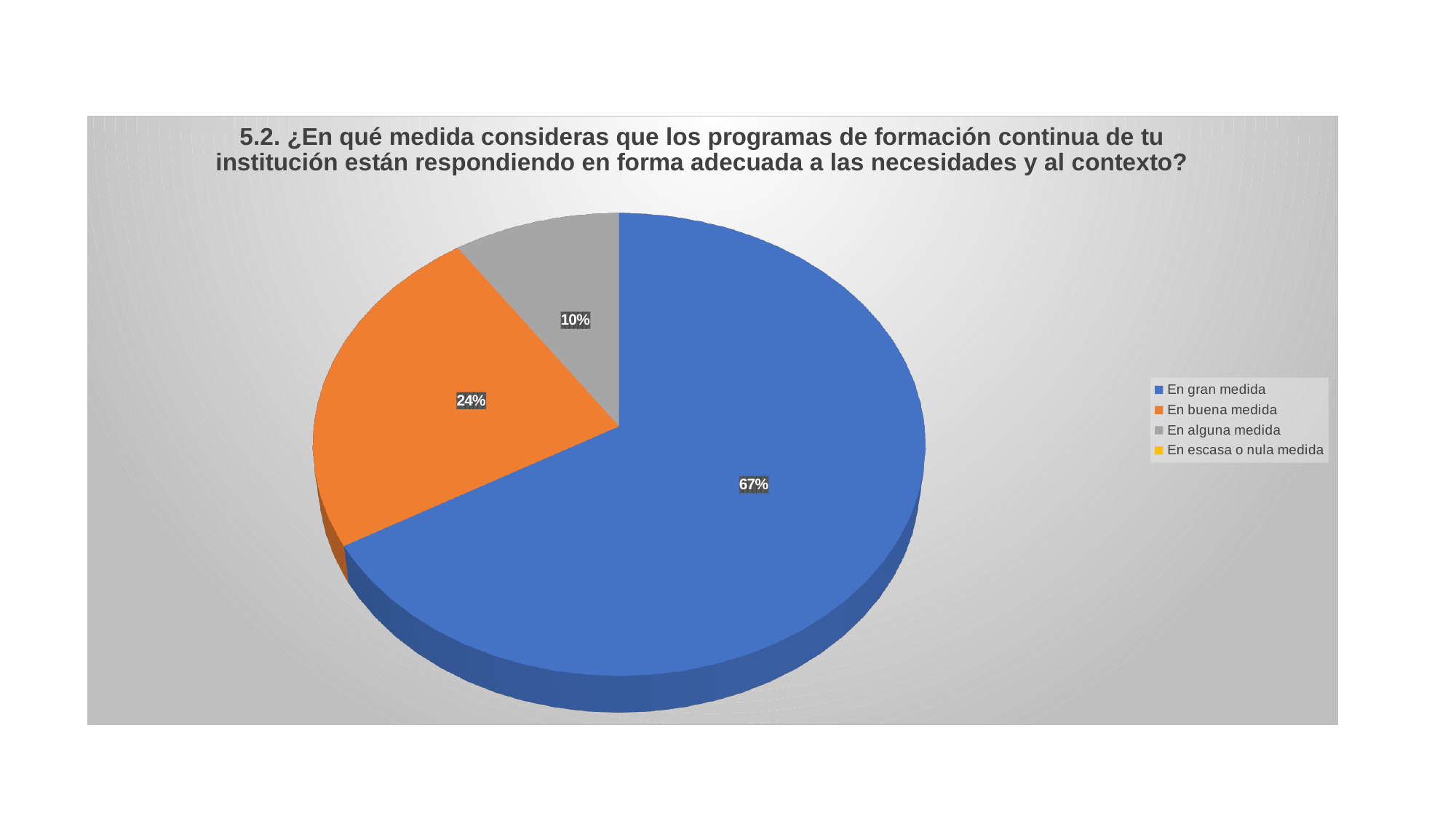
What share of the pie does "En buena medida" represent? 24% Which colour represents "En buena medida" in the pie chart? Orange Which category has the largest slice of the pie? En gran medida How many categories does the legend list? 4 Which of the labelled slices is the smallest? En alguna medida What is the difference in percentage points between "En buena medida" and "En alguna medida"? 14 What share of the pie does "En gran medida" represent? 67% Which legend category is shown in yellow? En escasa o nula medida Which is larger, the share for "En buena medida" or the share for "En alguna medida"? En buena medida What share of the pie does "En alguna medida" represent? 10% What kind of chart is shown on the slide? Pie chart What is the difference in percentage points between "En gran medida" and "En buena medida"? 43